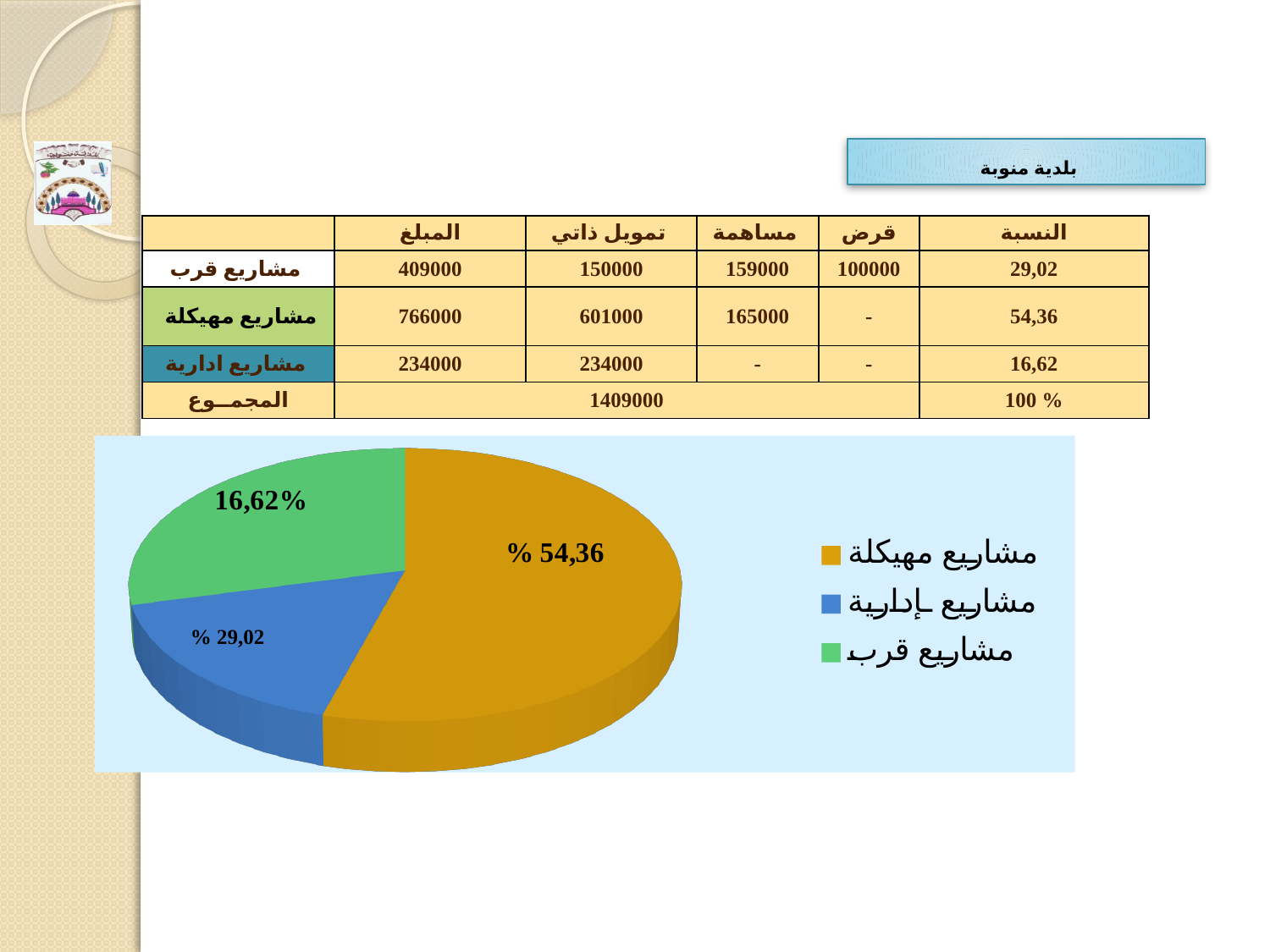
What share of the pie does مشاريع مهيكلة have? 54,36% How many slices does the pie chart have? 3 Is the share for مشاريع مهيكلة greater or less than 50%? greater What kind of chart is shown on the slide? pie chart What is the total of the three percentages shown on the pie chart? 100% What is the smallest percentage printed on the pie chart? 16,62% Which legend entry is shown in green in the pie chart? مشاريع قرب How many entries does the pie chart's legend list? 3 Which category has the largest slice in the pie chart? مشاريع مهيكلة What colour is the slice for مشاريع مهيكلة in the pie chart? orange